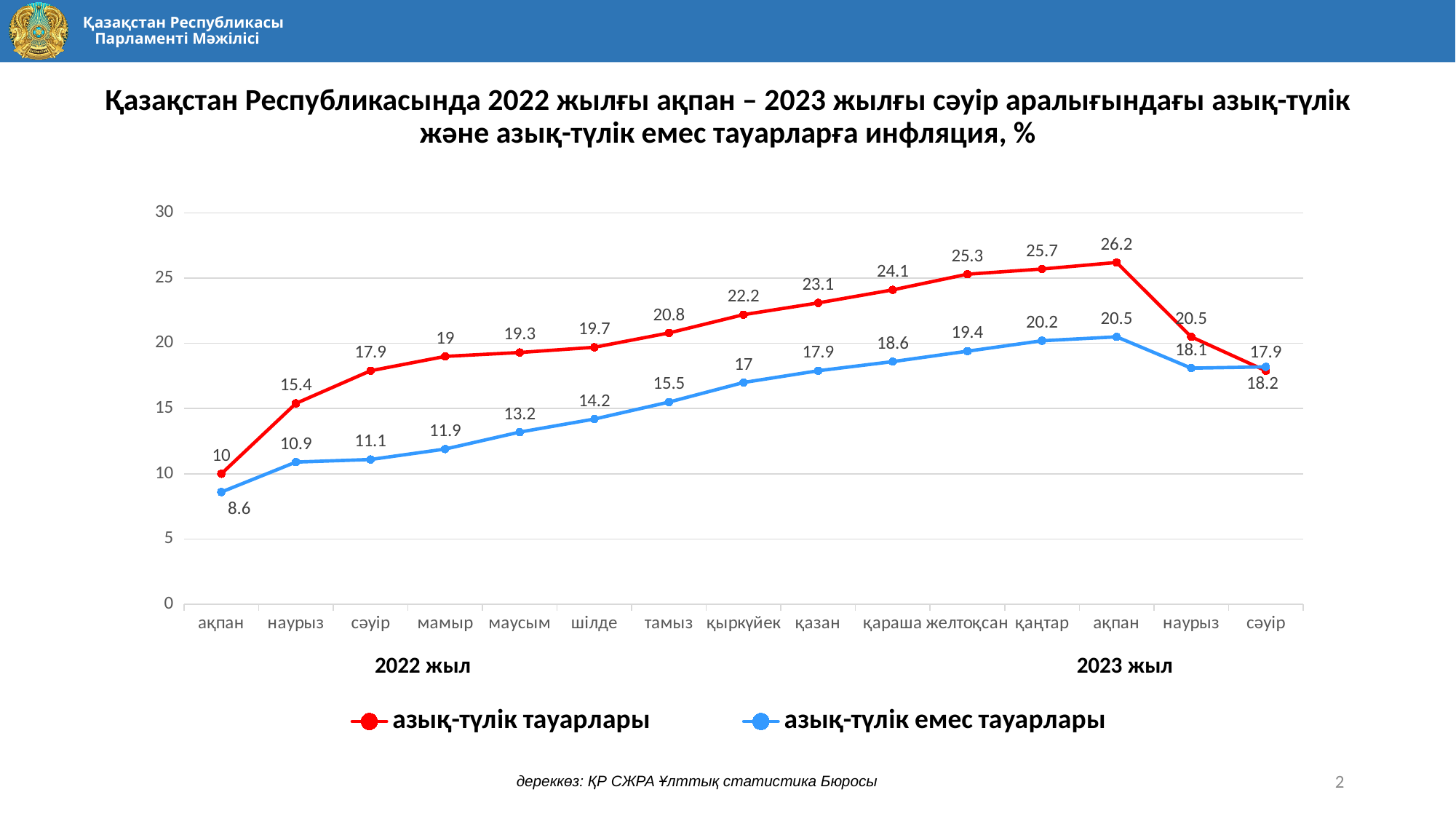
What kind of chart is shown on the slide? line chart What is the value for азық-түлік тауарлары in наурыз 2023? 20.5 How many series does the legend list? 2 What is the value for азық-түлік емес тауарлары in ақпан 2022? 8.6 What is the difference between азық-түлік тауарлары and азық-түлік емес тауарлары in ақпан 2023? 5.7 Does the value for азық-түлік тауарлары rise or fall from ақпан 2022 to ақпан 2023? rise What is the value for азық-түлік емес тауарлары in қаңтар 2023? 20.2 In which month is азық-түлік емес тауарлары at its lowest value? ақпан 2022 What is the value for азық-түлік тауарлары in ақпан 2022? 10 In қазан 2022, which series has the higher value, азық-түлік тауарлары or азық-түлік емес тауарлары? азық-түлік тауарлары In which month does азық-түлік тауарлары reach its highest value? ақпан 2023 How many months are plotted on the x axis? 15